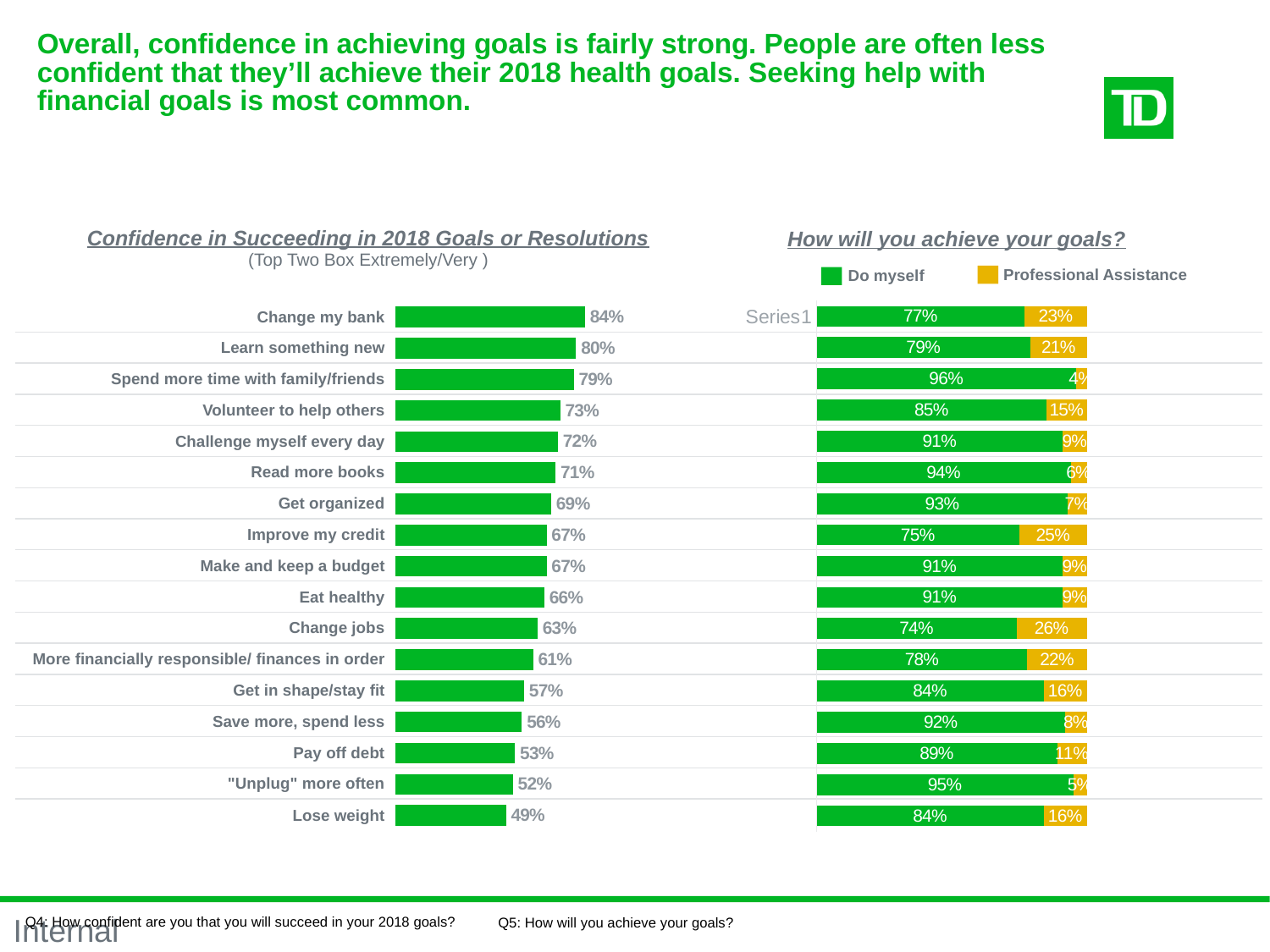
In the 'How will you achieve your goals?' chart, which category has the highest 'Professional Assistance' value? Change jobs In the 'Confidence in Succeeding in 2018 Goals or Resolutions' chart, what is the value for 'Volunteer to help others'? 73% In the 'How will you achieve your goals?' chart, is the 'Do myself' value larger for 'Read more books' or for 'Improve my credit'? Read more books In the 'How will you achieve your goals?' chart, what is the 'Professional Assistance' value for 'Change jobs'? 26% In the 'How will you achieve your goals?' chart, how many series does the legend list? 2 In the 'Confidence in Succeeding in 2018 Goals or Resolutions' chart, what is the difference between 'Learn something new' and 'Pay off debt'? 27% In the 'Confidence in Succeeding in 2018 Goals or Resolutions' chart, how many categories are shown? 17 In the 'How will you achieve your goals?' chart, what is the 'Do myself' value for 'Spend more time with family/friends'? 96% In the 'Confidence in Succeeding in 2018 Goals or Resolutions' chart, which category has the lowest value? Lose weight In the 'How will you achieve your goals?' chart, what colour represents 'Professional Assistance'? Yellow In the 'Confidence in Succeeding in 2018 Goals or Resolutions' chart, which category has the highest value? Change my bank What kind of chart is the 'Confidence in Succeeding in 2018 Goals or Resolutions' chart? Bar chart